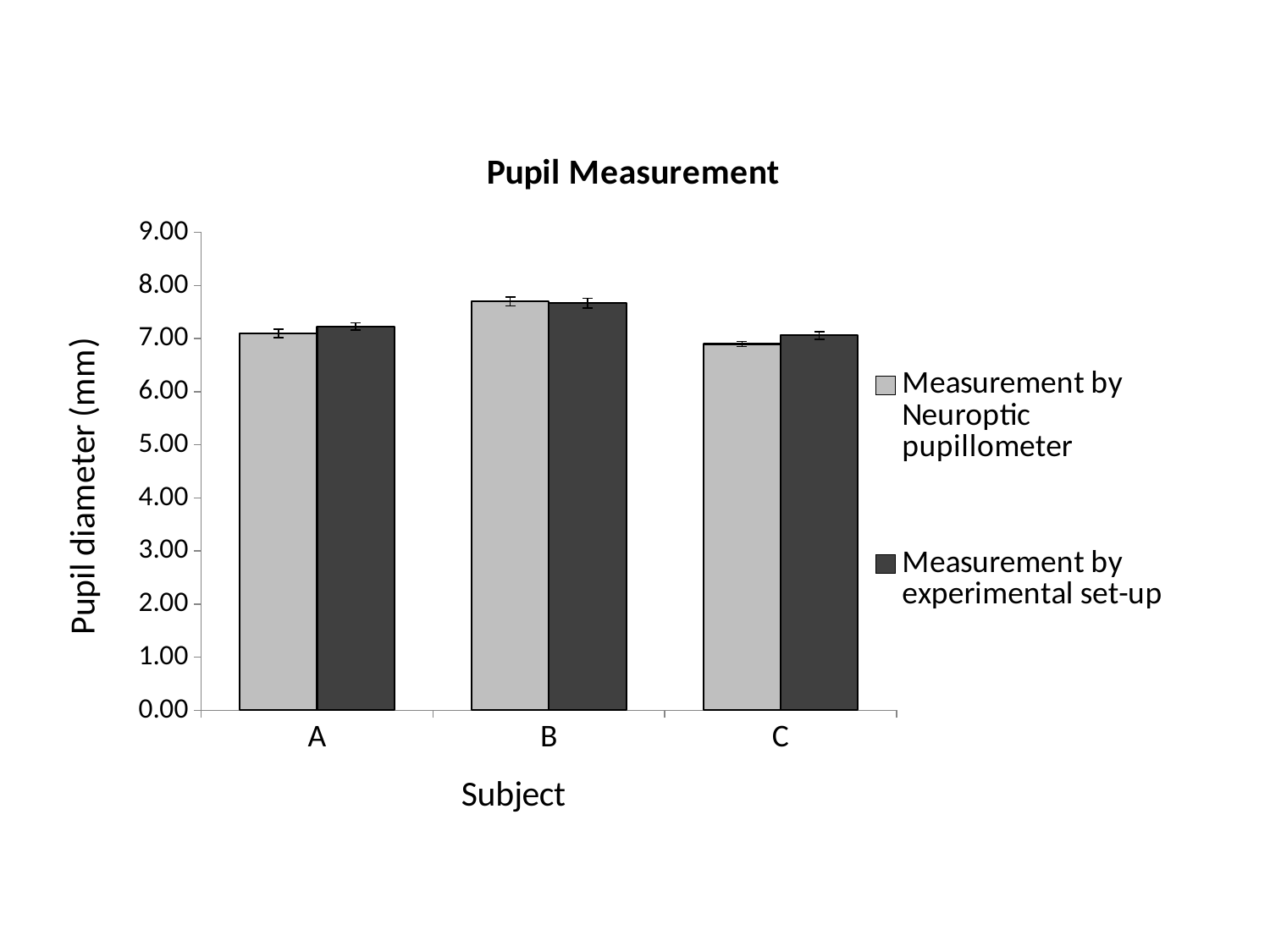
Which subject has the highest value for Measurement by Neuroptic pupillometer? B For Measurement by Neuroptic pupillometer, which is larger: subject B or subject C? B What is the label of the y axis? Pupil diameter (mm) Which subject has the highest value for Measurement by experimental set-up? B How many series does the legend list? 2 How many subjects are shown on the x axis? 3 Which subject has the lowest value for Measurement by Neuroptic pupillometer? C Is the value for subject C measured by experimental set-up greater or less than 8.00? less What type of chart is shown on the slide? Bar chart For Measurement by experimental set-up, which is larger: subject A or subject B? B Is the value for subject B measured by Neuroptic pupillometer greater or less than 7.00? greater What is the title of the chart? Pupil Measurement